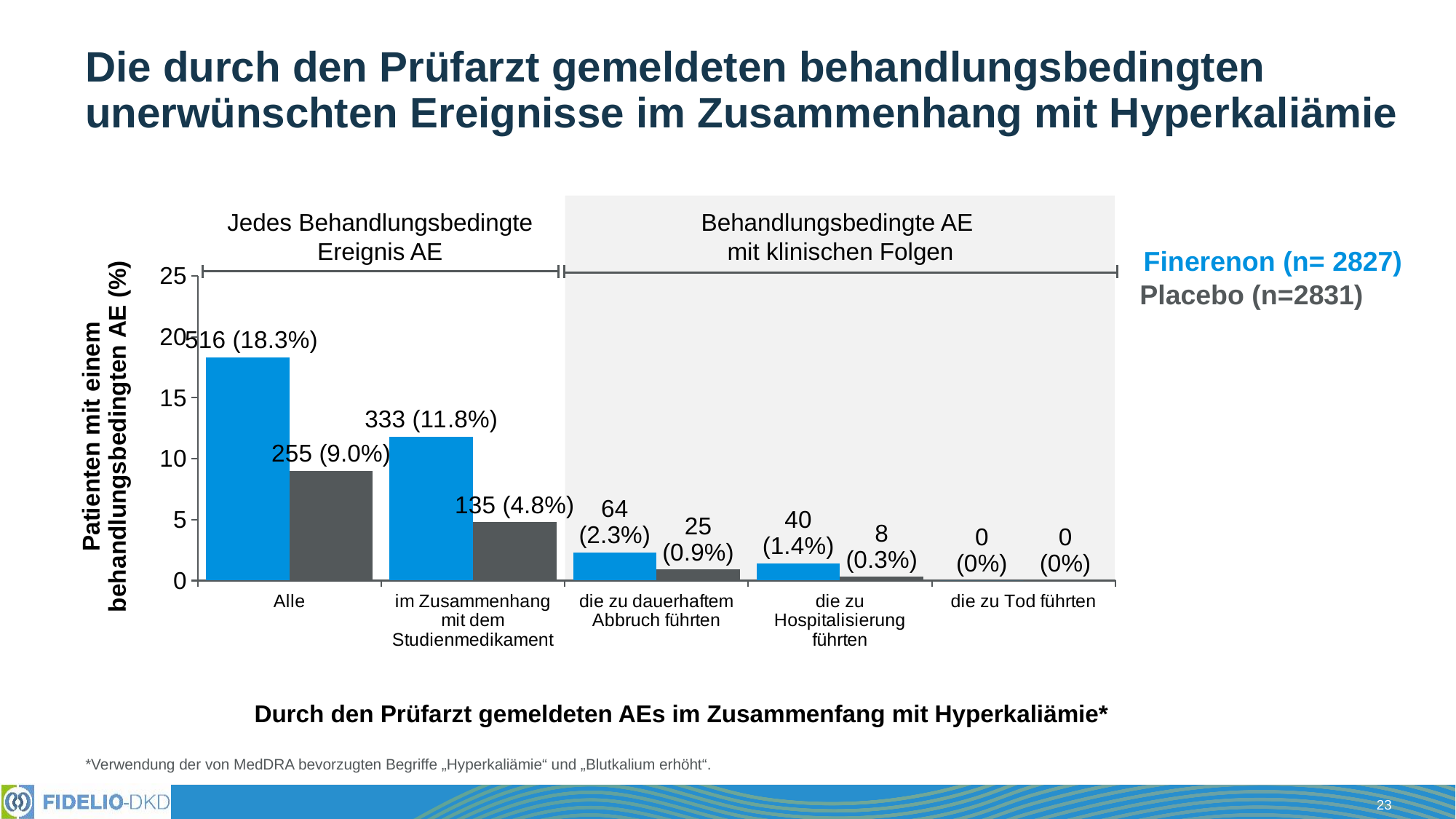
What is the difference in percentage points between Finerenon and Placebo in the "Alle" category? 9.3 How many Placebo patients had an AE "die zu Hospitalisierung führten"? 8 How many categories are shown on the x axis? 5 What percentage of Finerenon patients had an AE "im Zusammenhang mit dem Studienmedikament"? 11.8% What is the data label for Placebo in the "Alle" category? 255 (9.0%) What is the data label for Finerenon in the category "die zu dauerhaftem Abbruch führten"? 64 (2.3%) Which category has the highest value for Finerenon? Alle What is the data label for Finerenon in the "Alle" category? 516 (18.3%) In the category "im Zusammenhang mit dem Studienmedikament", which series has the larger value, Finerenon or Placebo? Finerenon Which category has the lowest value for Placebo? die zu Tod führten How many series does the chart show? 2 What kind of chart is shown on the slide? Bar chart